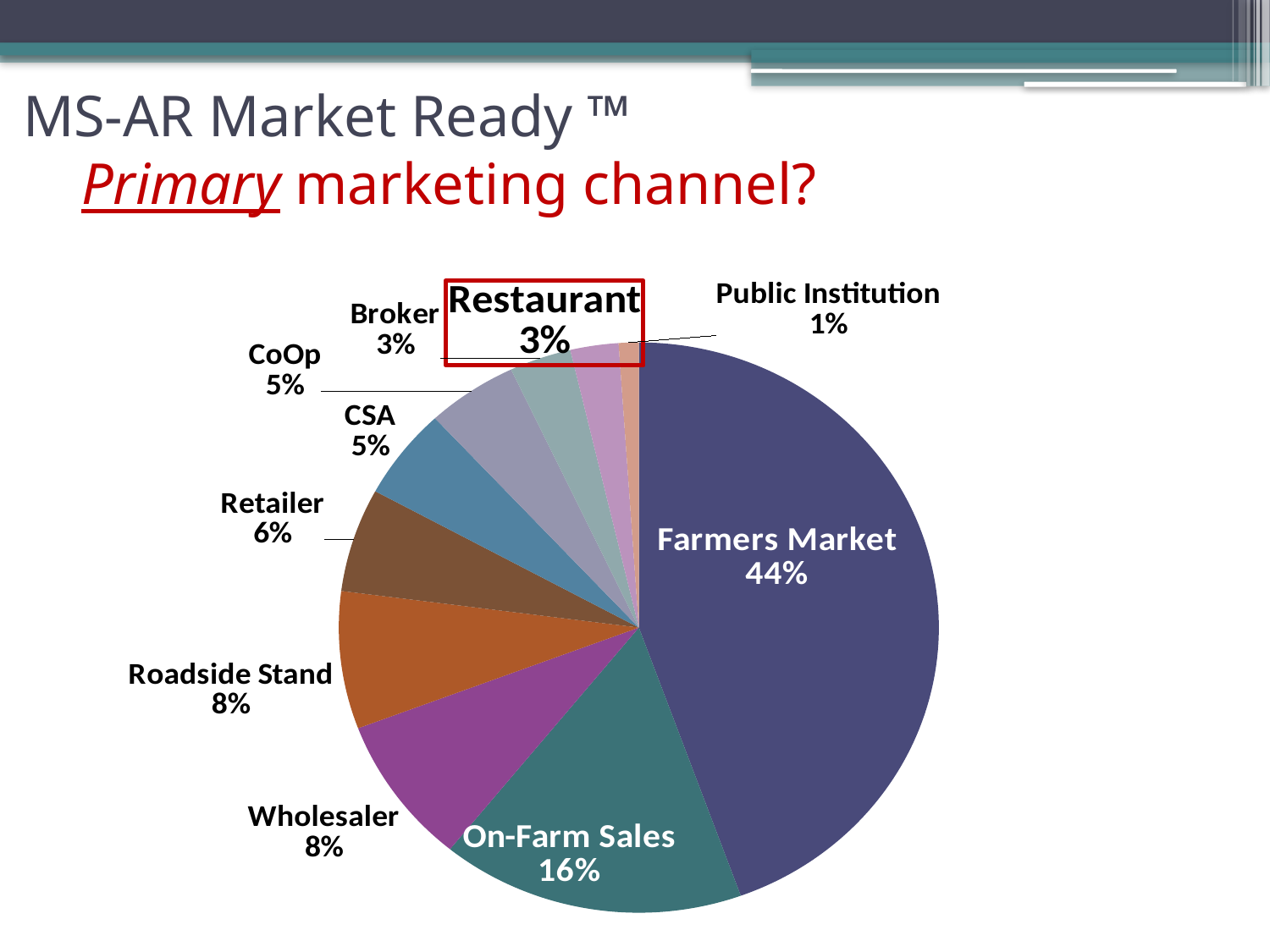
Which is larger, the share for Retailer or the share for CoOp? Retailer What share of the pie does Farmers Market have? 44% Which category label is outlined with a red box on the slide? Restaurant Which category has the largest slice of the pie? Farmers Market Which category has the smallest slice of the pie? Public Institution What is the value for Retailer? 6% What is the difference between the Farmers Market share and the On-Farm Sales share? 28% What is the value for On-Farm Sales? 16% What kind of chart is shown on the slide? pie chart What is the value for Roadside Stand? 8% How many categories are shown in the pie chart? 10 What is the value for Public Institution? 1%